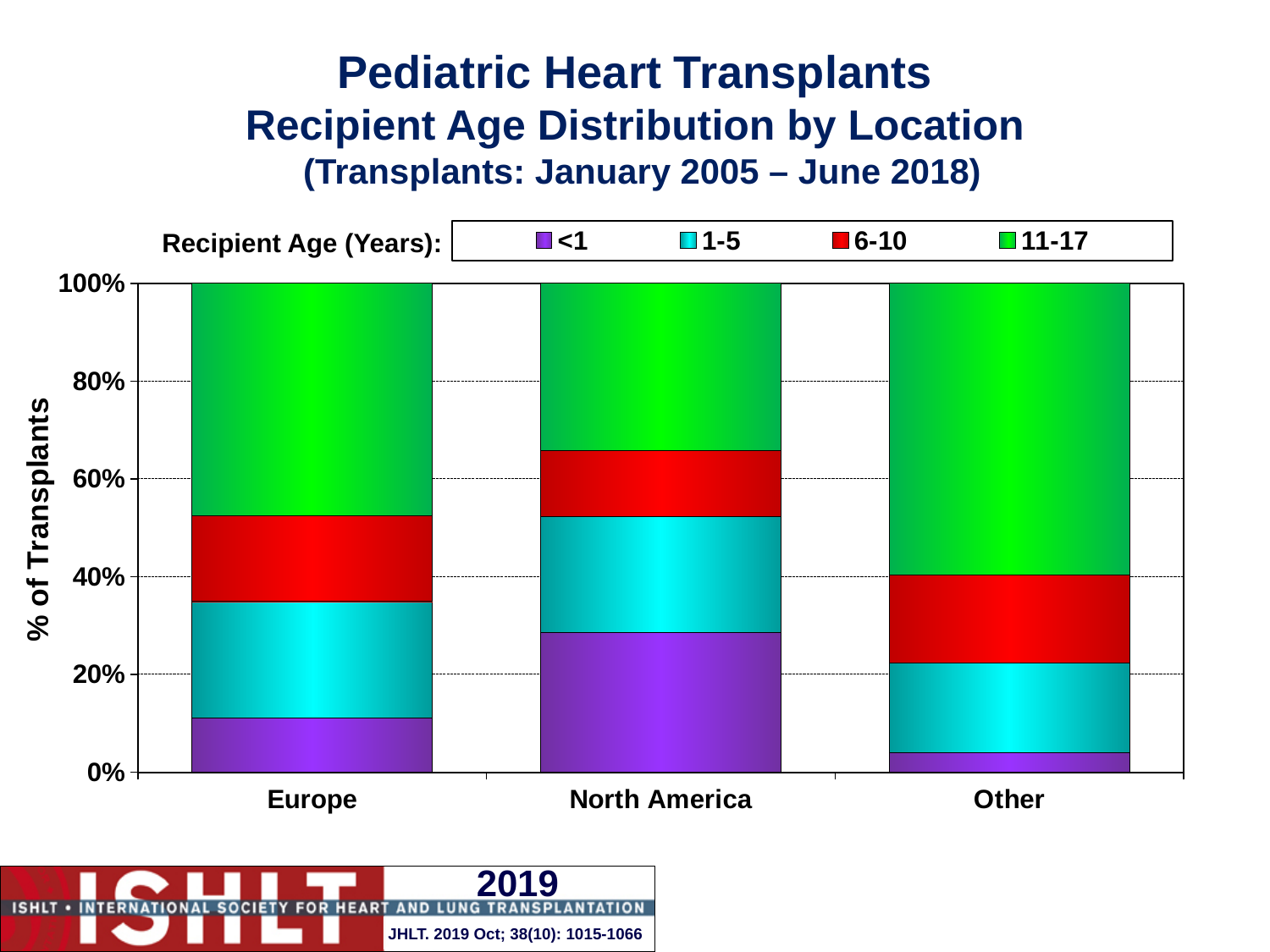
Is the share of recipients aged <1 year in North America greater or less than 20%? greater Which location has the largest share of recipients aged <1 year? North America Which location has the smallest share of recipients aged <1 year? Other Is the share of recipients aged <1 year in Europe greater or less than 20%? less How many recipient age groups does the legend list? 4 What kind of chart is shown on the slide? Stacked bar chart Which location has the largest share of recipients aged 11-17 years? Other How many locations are shown on the x axis? 3 Is the share of recipients aged 11-17 years in Other greater or less than 50%? greater What is the label of the y axis? % of Transplants Which location has the smallest share of recipients aged 11-17 years? North America Which has a larger share of recipients aged 11-17 years, Europe or North America? Europe